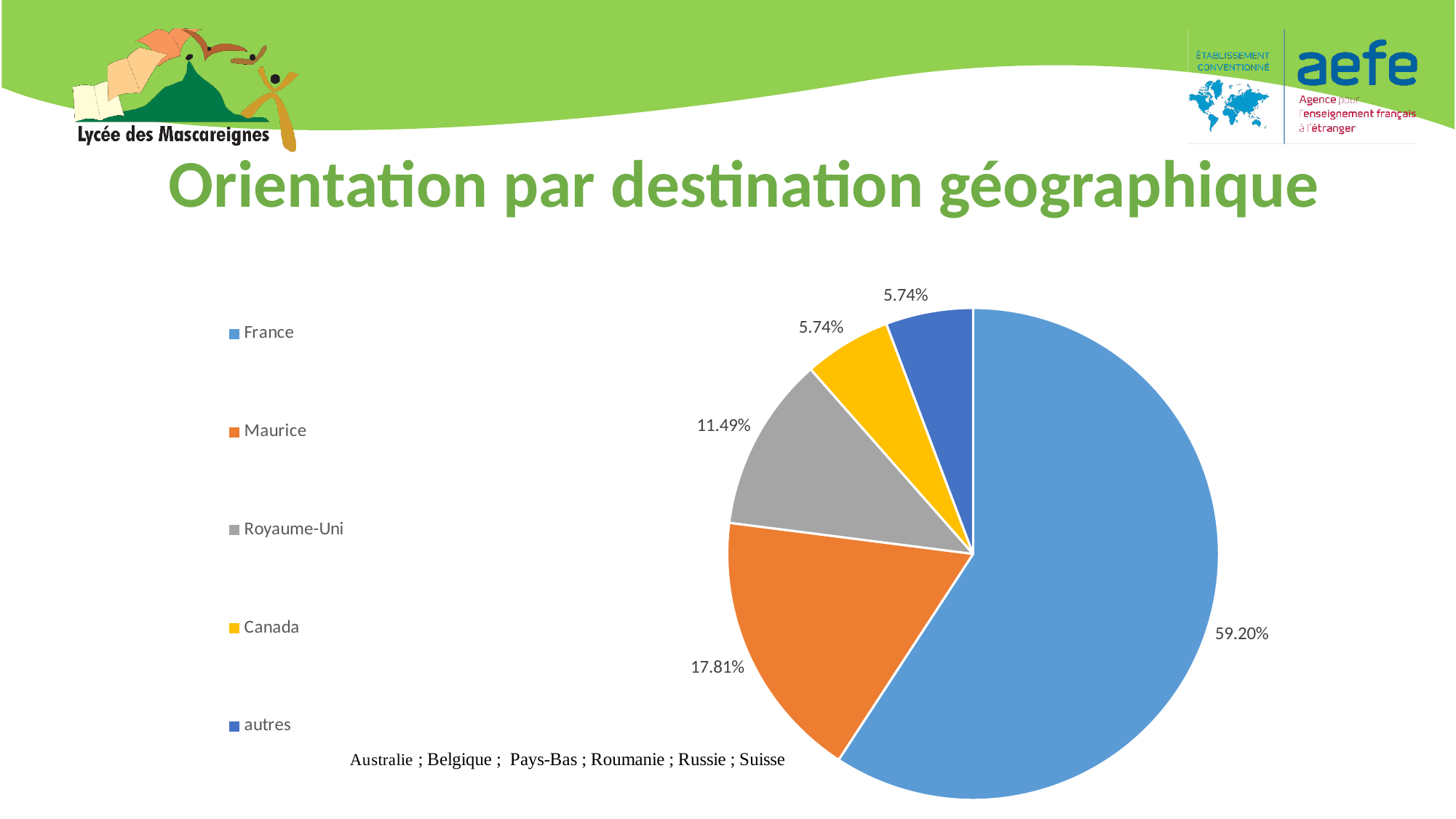
Which destination has the largest slice of the pie? France What is the value shown for Canada? 5.74% What is the title of the slide containing the chart? Orientation par destination géographique What is the value shown for Maurice? 17.81% What share of the pie does France represent? 59.20% What is the difference in percentage points between Maurice and Royaume-Uni? 6.32 Which is larger, the share for Maurice or the share for Royaume-Uni? Maurice Which colour is used for the Canada slice in the pie chart? yellow What percentage is shown for Royaume-Uni? 11.49% What is the difference in percentage points between France and Maurice? 41.39 What type of chart is shown on the slide? pie chart How many slices does the pie chart have? 5